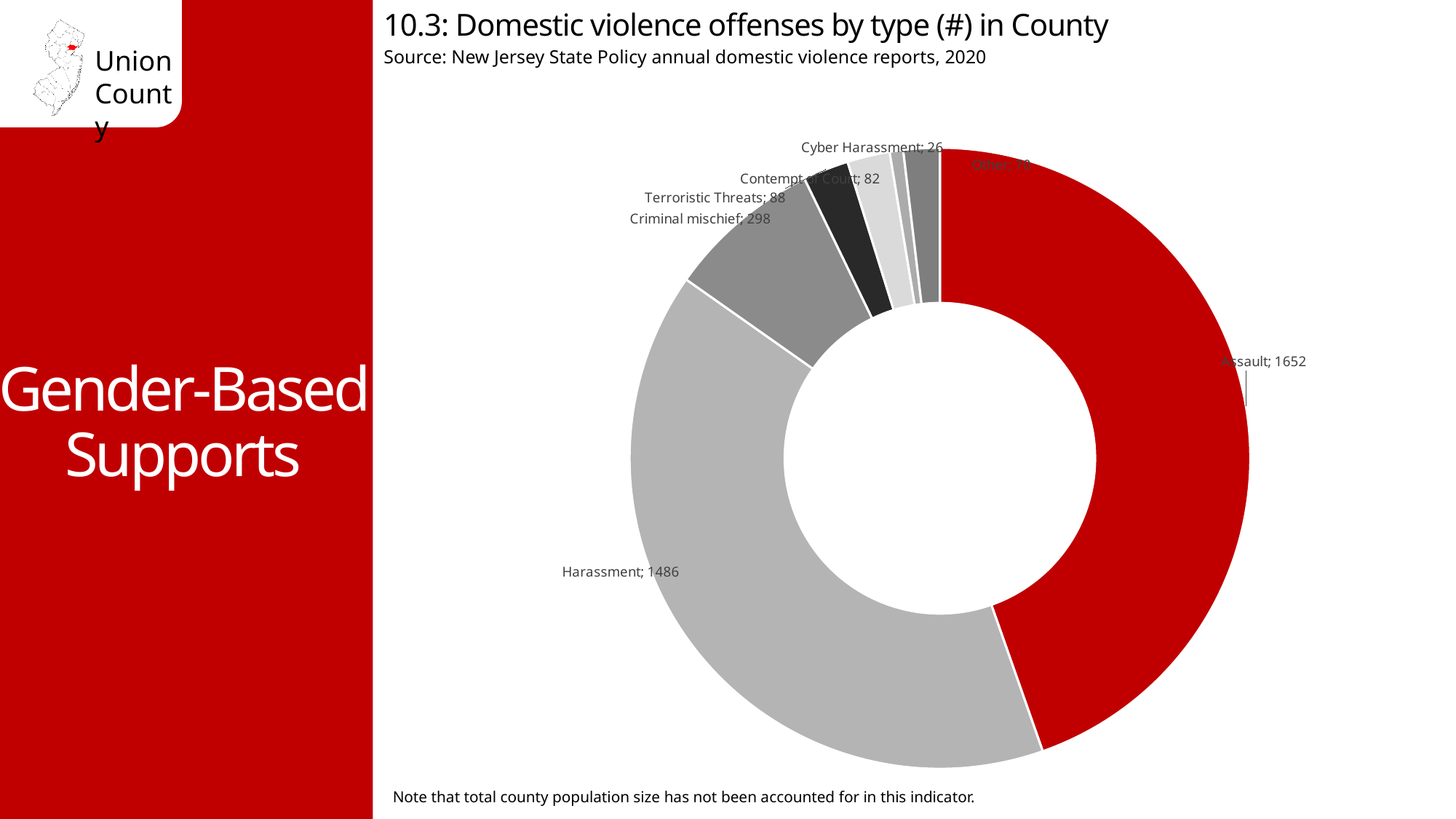
What is the value shown for Harassment? 1486 How many offense types are shown on the chart? 7 Which offense type has the smallest number of offenses? Cyber Harassment Which is larger, Terroristic Threats or Contempt of Court? Terroristic Threats What is the difference between the Assault and Harassment values? 166 How many domestic violence offenses of type Assault are shown on the chart? 1652 What is the value shown for Contempt of Court? 82 Which offense type has the largest number of offenses? Assault What is the value shown for Cyber Harassment? 26 What kind of chart is shown on the slide? Doughnut (pie) chart What is the difference between the Criminal mischief and Terroristic Threats values? 210 What is the value shown for Criminal mischief? 298